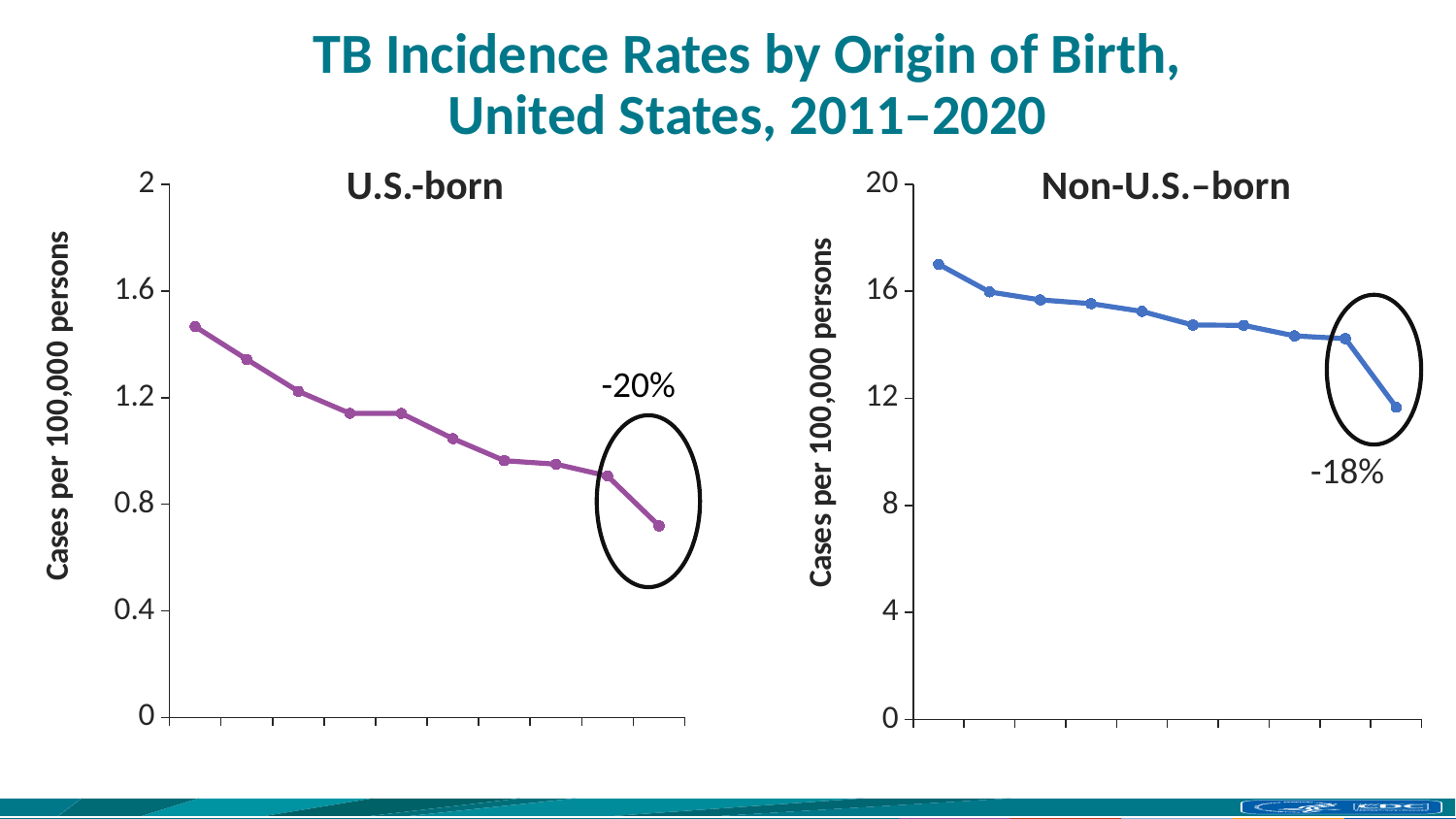
In the U.S.-born chart, is the value of the first (leftmost) point greater or less than 1.2? greater In the Non-U.S.-born chart, is the value of the last (rightmost) point greater or less than 12? less In the U.S.-born chart, how many data points are plotted on the line? 10 What kind of chart is the U.S.-born chart? line chart In the U.S.-born chart, is the value of the last (rightmost) point greater or less than 0.8? less In the U.S.-born chart, what percentage change is annotated next to the circled final drop? -20% In the Non-U.S.-born chart, how many data points are plotted on the line? 10 In the Non-U.S.-born chart, do the values rise or fall from left to right along the x axis? fall In the U.S.-born chart, do the values rise or fall from left to right along the x axis? fall In the Non-U.S.-born chart, what percentage change is annotated next to the circled final drop? -18% What kind of chart is the Non-U.S.-born chart? line chart